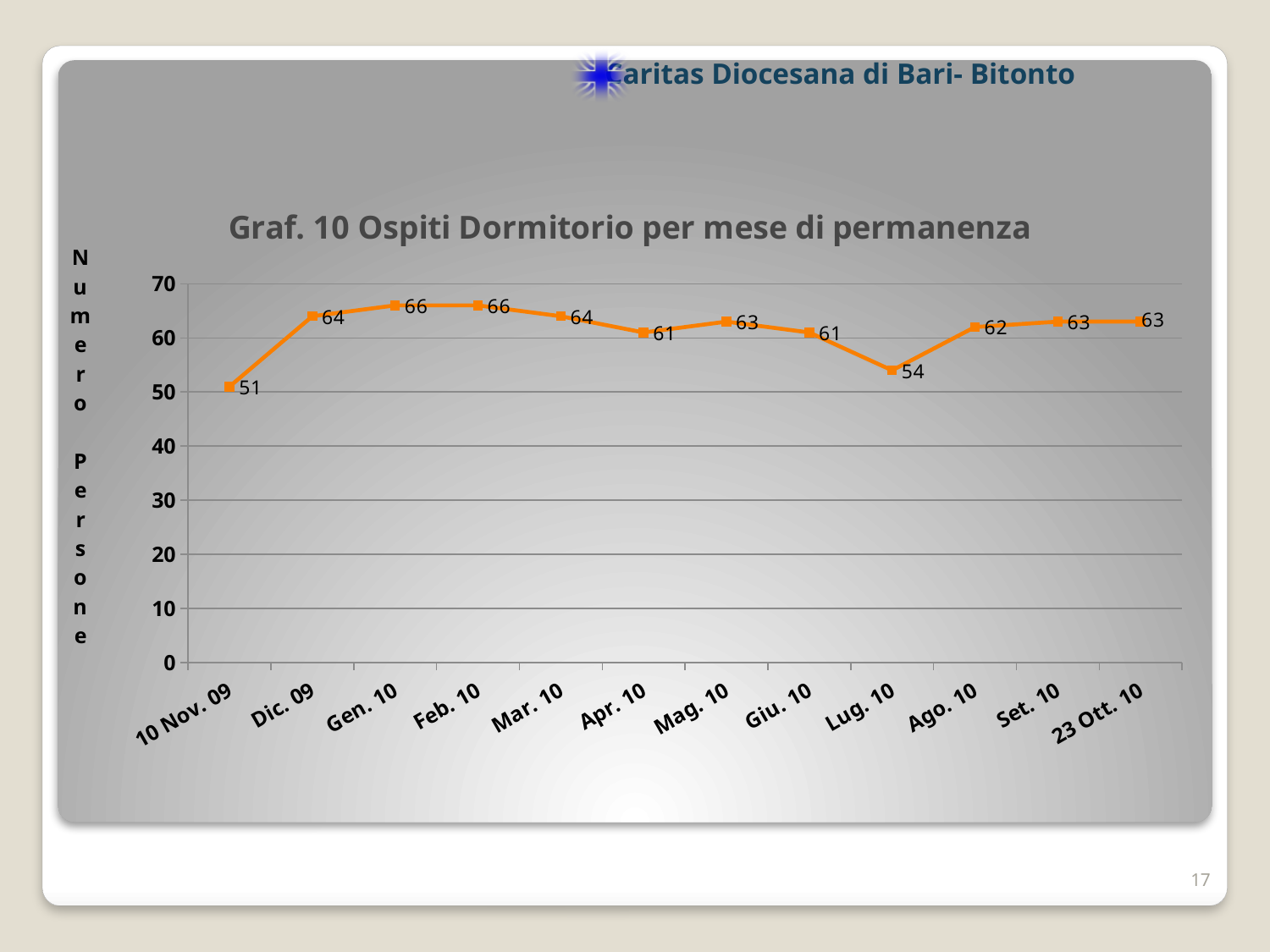
Does the value rise or fall from Giu. 10 to Lug. 10? Fall What is the value for Apr. 10? 61 What is the title of the chart? Graf. 10 Ospiti Dormitorio per mese di permanenza What is the difference between the values for Dic. 09 and 10 Nov. 09? 13 What is the value for Lug. 10? 54 What type of chart is shown on the slide? Line chart What is the value for 10 Nov. 09? 51 What is the value for Ago. 10? 62 Which category has the lowest value? 10 Nov. 09 Which is larger, the value for Giu. 10 or the value for Lug. 10? Giu. 10 How many data points are plotted on the chart? 12 What is the highest value plotted on the chart? 66